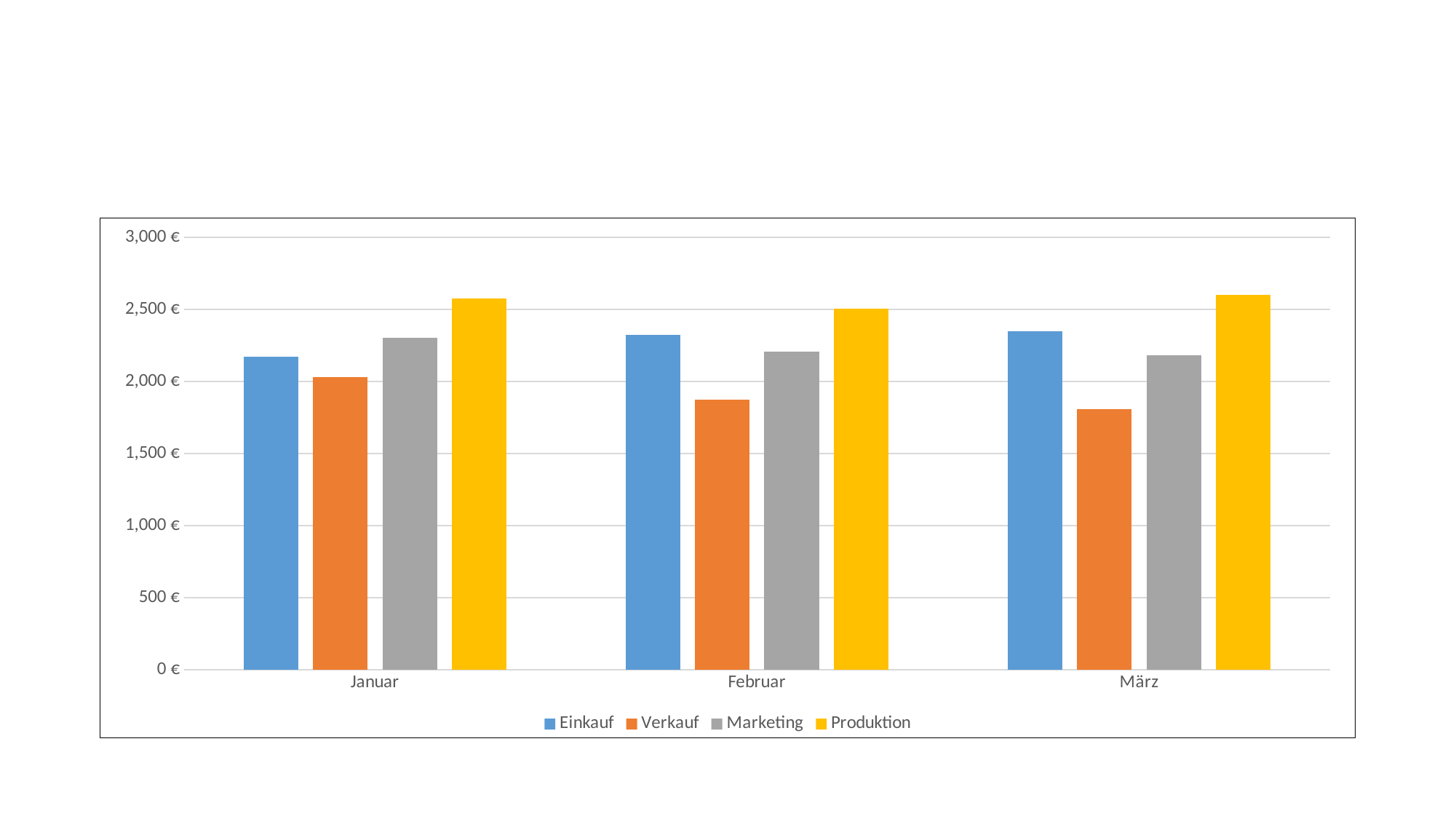
How many series does the legend list? 4 Which series has the lowest value in März? Verkauf Is the value for Einkauf in März greater or less than 2,000 €? greater Is the value for Produktion in Januar greater or less than 2,500 €? greater What kind of chart is shown on the slide? bar chart Do the values for Verkauf rise or fall from Januar to März? fall In Januar, which is larger: Einkauf or Marketing? Marketing Which series is shown in yellow? Produktion Which series has the lowest value in Februar? Verkauf Which series has the highest value in Januar? Produktion How many categories are shown on the x axis? 3 Is the value for Verkauf in Februar greater or less than 2,000 €? less